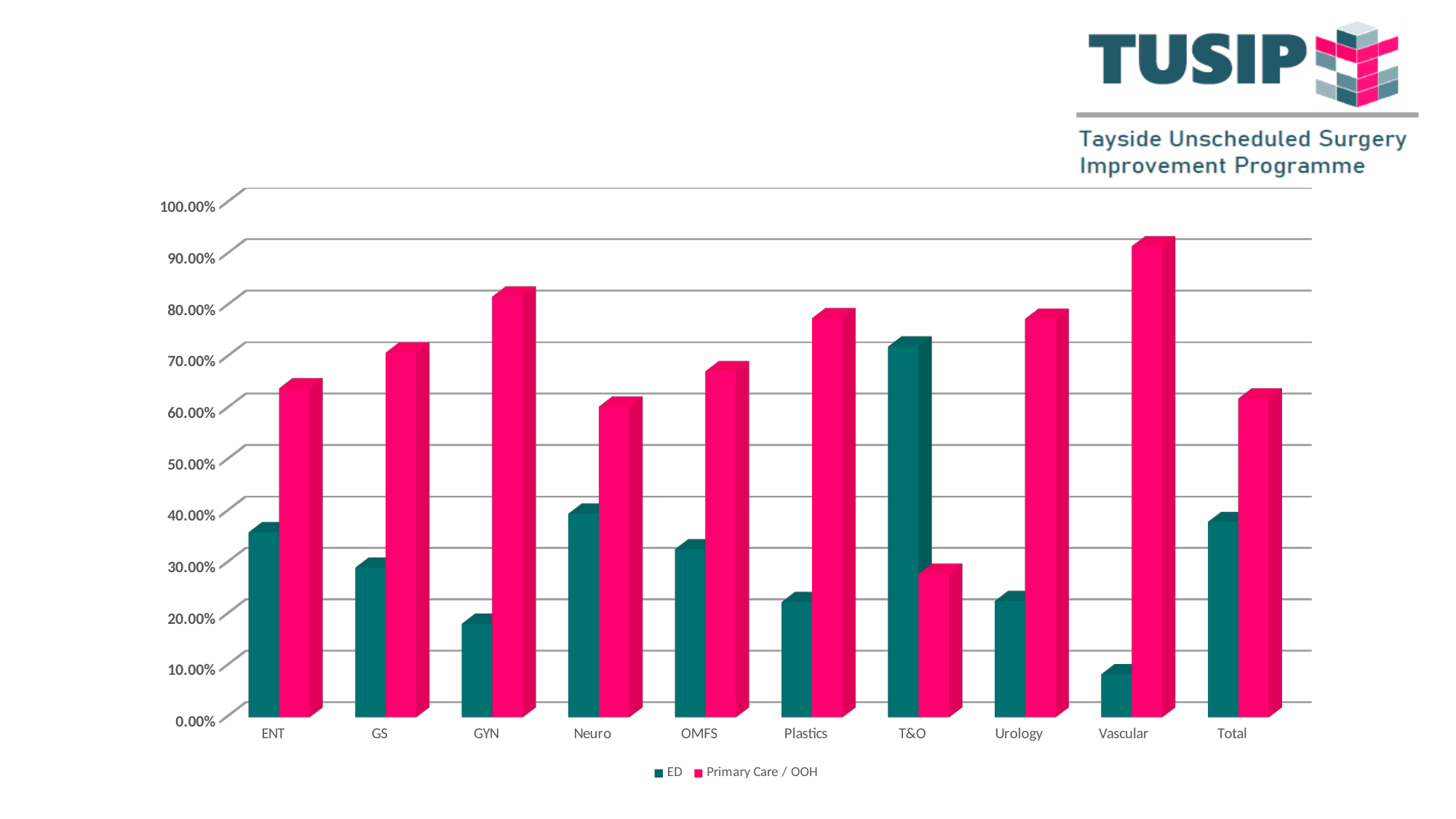
Which category has the lowest Primary Care / OOH value? T&O Which category has the highest ED value? T&O How many categories are shown on the x axis? 10 Which category has the highest Primary Care / OOH value? Vascular For ENT, which is larger: the ED value or the Primary Care / OOH value? Primary Care / OOH For T&O, which is larger: the ED value or the Primary Care / OOH value? ED Is the ED value for Vascular greater or less than 20.00%? less Is the Primary Care / OOH value for Vascular greater or less than 80.00%? greater Is the ED value for T&O greater or less than 60.00%? greater Which category has the lowest ED value? Vascular What kind of chart is shown on the slide? bar chart How many series does the legend list? 2